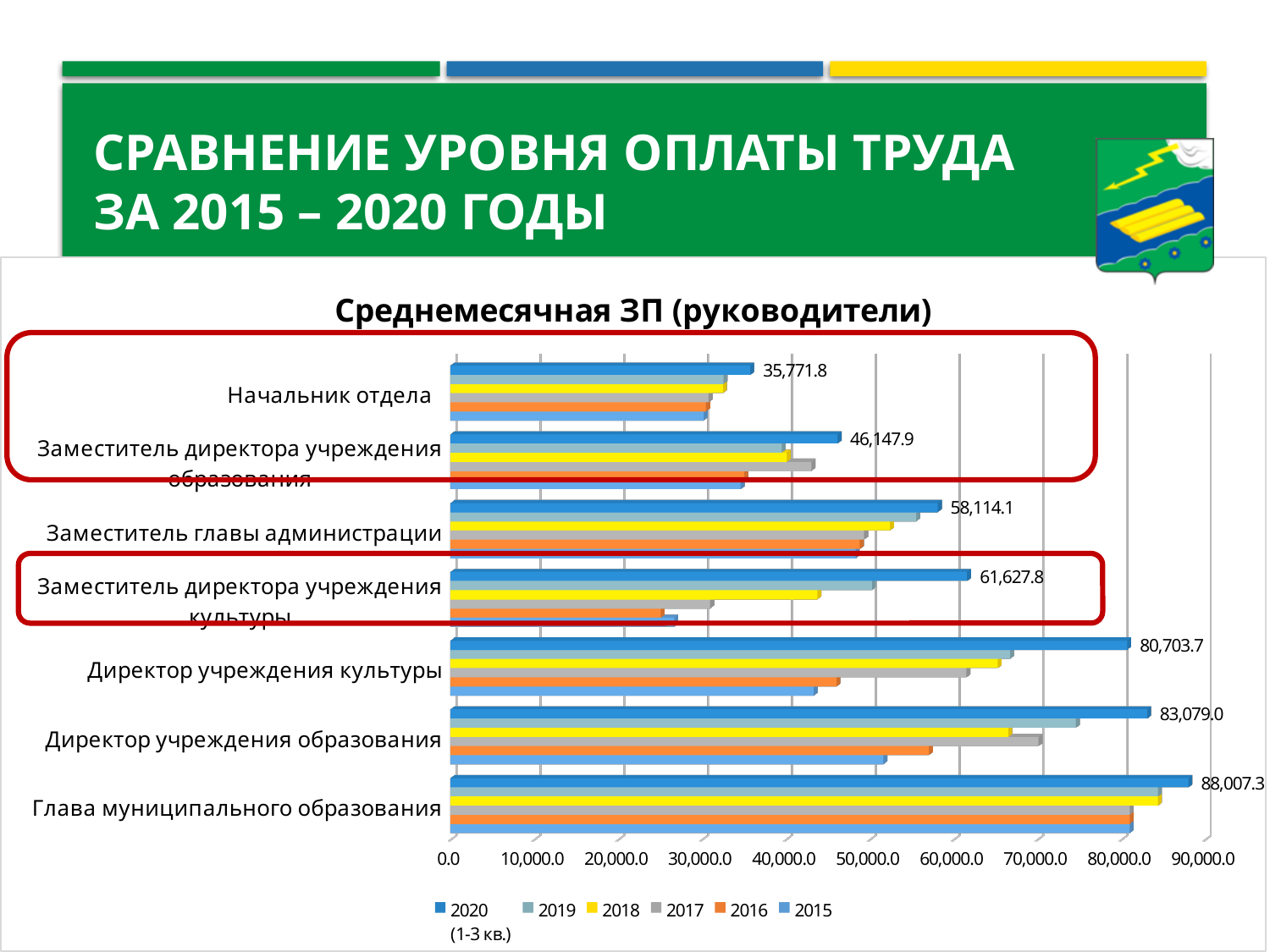
What type of chart is shown on the slide? bar chart What is the 2020 (1-3 кв.) value for Глава муниципального образования? 88,007.3 How many job categories are shown on the chart? 7 Which category has the lowest 2020 (1-3 кв.) value? Начальник отдела Is the 2016 value for Заместитель директора учреждения культуры greater or less than 30,000.0? less What is the difference between the 2020 (1-3 кв.) values for Директор учреждения образования and Директор учреждения культуры? 2,375.3 What is the 2020 (1-3 кв.) value for Заместитель директора учреждения образования? 46,147.9 Is the 2015 value for Глава муниципального образования greater or less than 70,000.0? greater Which category has the highest 2020 (1-3 кв.) value? Глава муниципального образования How many series does the legend list? 6 Which has the larger 2020 (1-3 кв.) value: Заместитель главы администрации or Заместитель директора учреждения культуры? Заместитель директора учреждения культуры What is the 2020 (1-3 кв.) value for Начальник отдела? 35,771.8